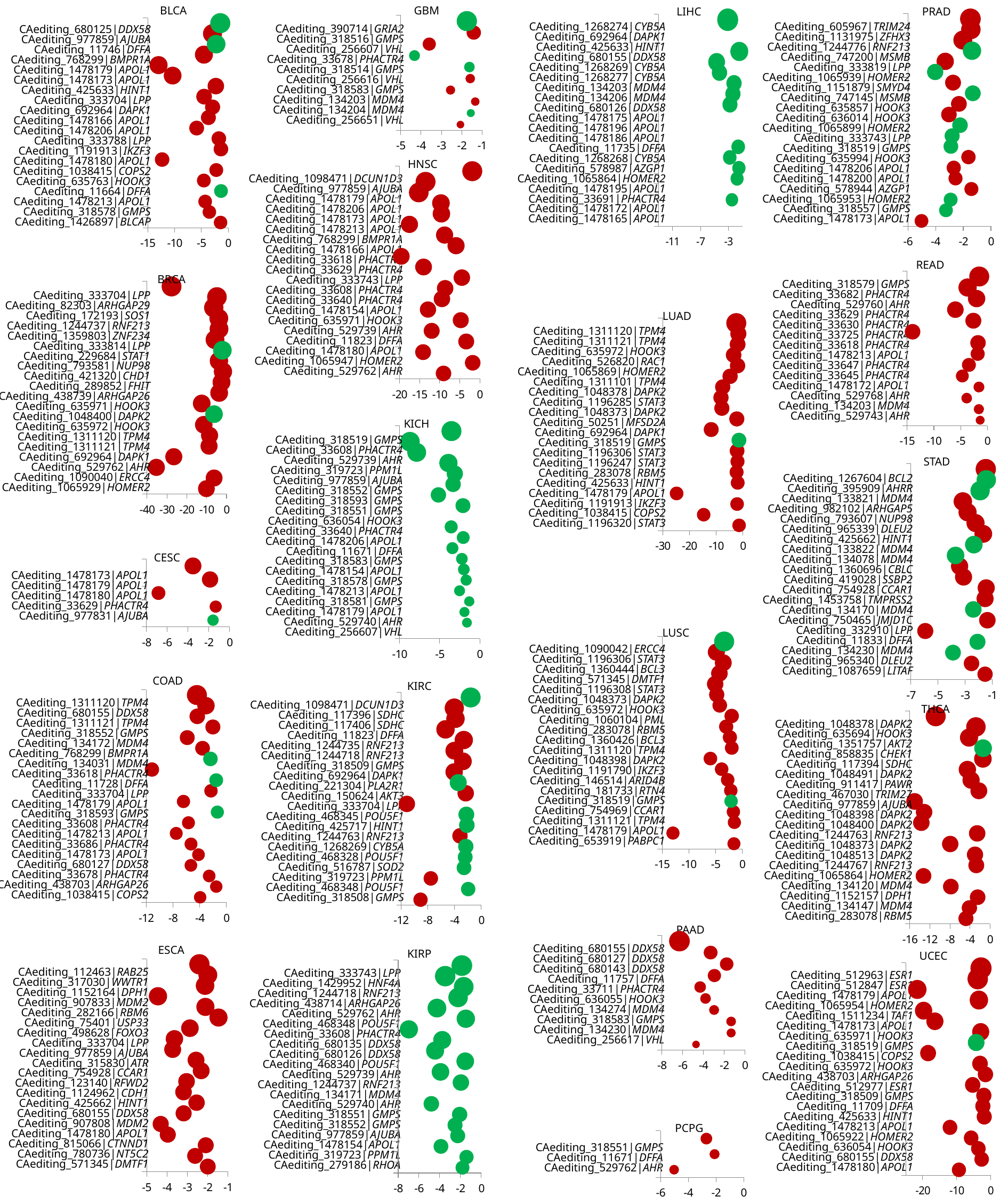
What two colours are used for the dots across the panels? red and green In the PAAD panel, which entry has the lowest (most negative) value? CAediting_680155|DDX58 In the PAAD panel, how many CAediting entries are listed? 10 In the BRCA panel, is the value for CAediting_333704|LPP greater or less than -20? less In the GBM panel, how many CAediting entries are listed? 10 In the LUAD panel, which entry has the lowest (most negative) value? CAediting_1478179|APOL1 In the CESC panel, which has the higher (less negative) value: CAediting_1478180|APOL1 or CAediting_977831|AJUBA? CAediting_977831|AJUBA In the PCPG panel, is the value for CAediting_529762|AHR greater or less than -4? less In the PCPG panel, how many CAediting entries are listed? 3 What kind of chart is used in each panel of this slide? bubble chart In the CESC panel, is the value for CAediting_1478180|APOL1 greater or less than -4? less